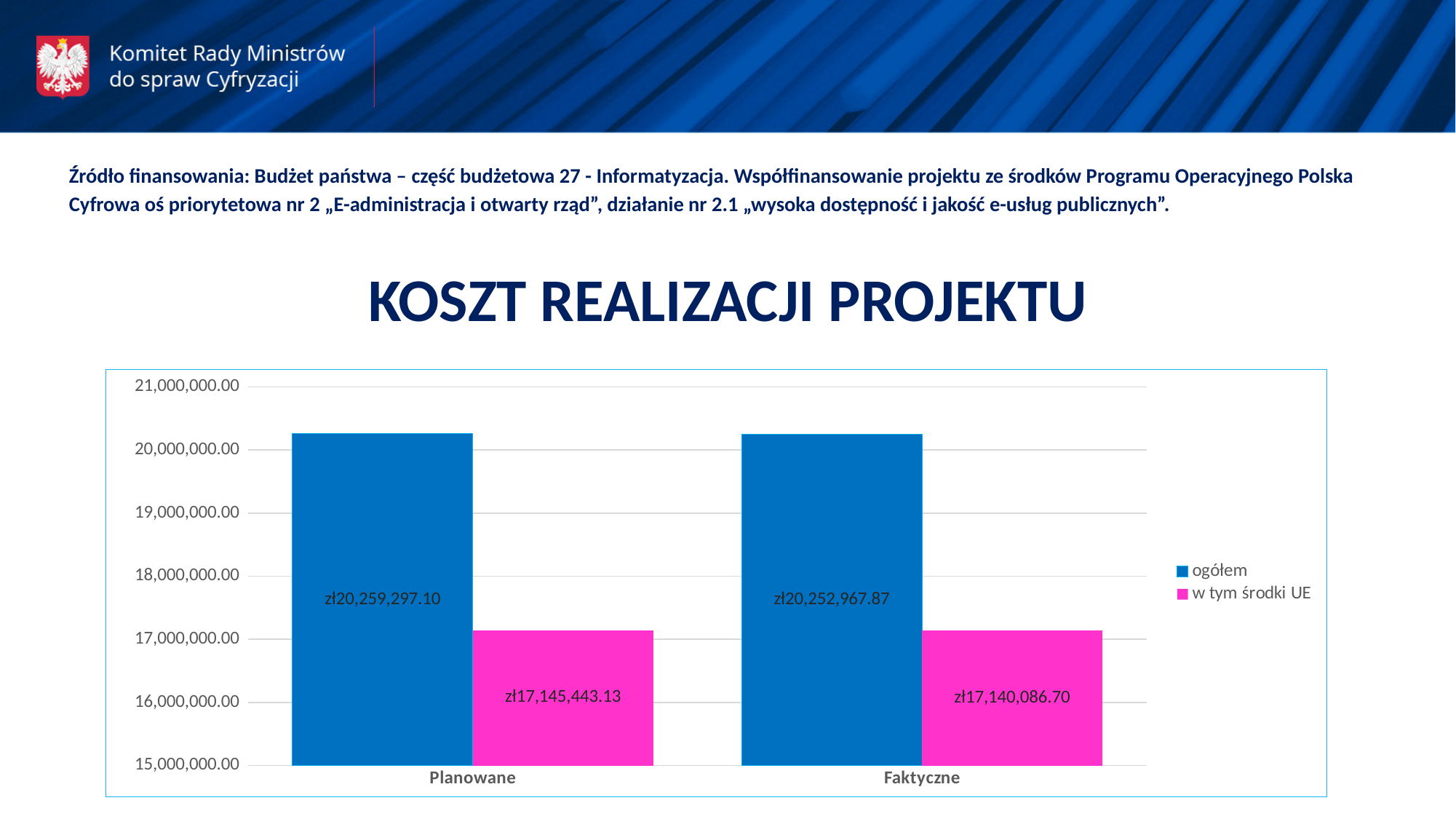
What type of chart is shown on the slide? bar chart What is the difference between the 'ogółem' and 'w tym środki UE' values for Planowane? zł3,113,853.97 Which bar in the chart has the highest value? ogółem for Planowane What is the value of the 'w tym środki UE' bar for Faktyczne? zł17,140,086.70 What is the value of the 'ogółem' bar for Planowane? zł20,259,297.10 What is the value of the 'w tym środki UE' bar for Planowane? zł17,145,443.13 How many series does the legend list? 2 What is the difference between the 'ogółem' values for Planowane and Faktyczne? zł6,329.23 For Faktyczne, which is larger: 'ogółem' or 'w tym środki UE'? ogółem Which bar in the chart has the lowest value? w tym środki UE for Faktyczne Is the 'w tym środki UE' value for Faktyczne greater or less than 17,000,000.00? greater What is the value of the 'ogółem' bar for Faktyczne? zł20,252,967.87